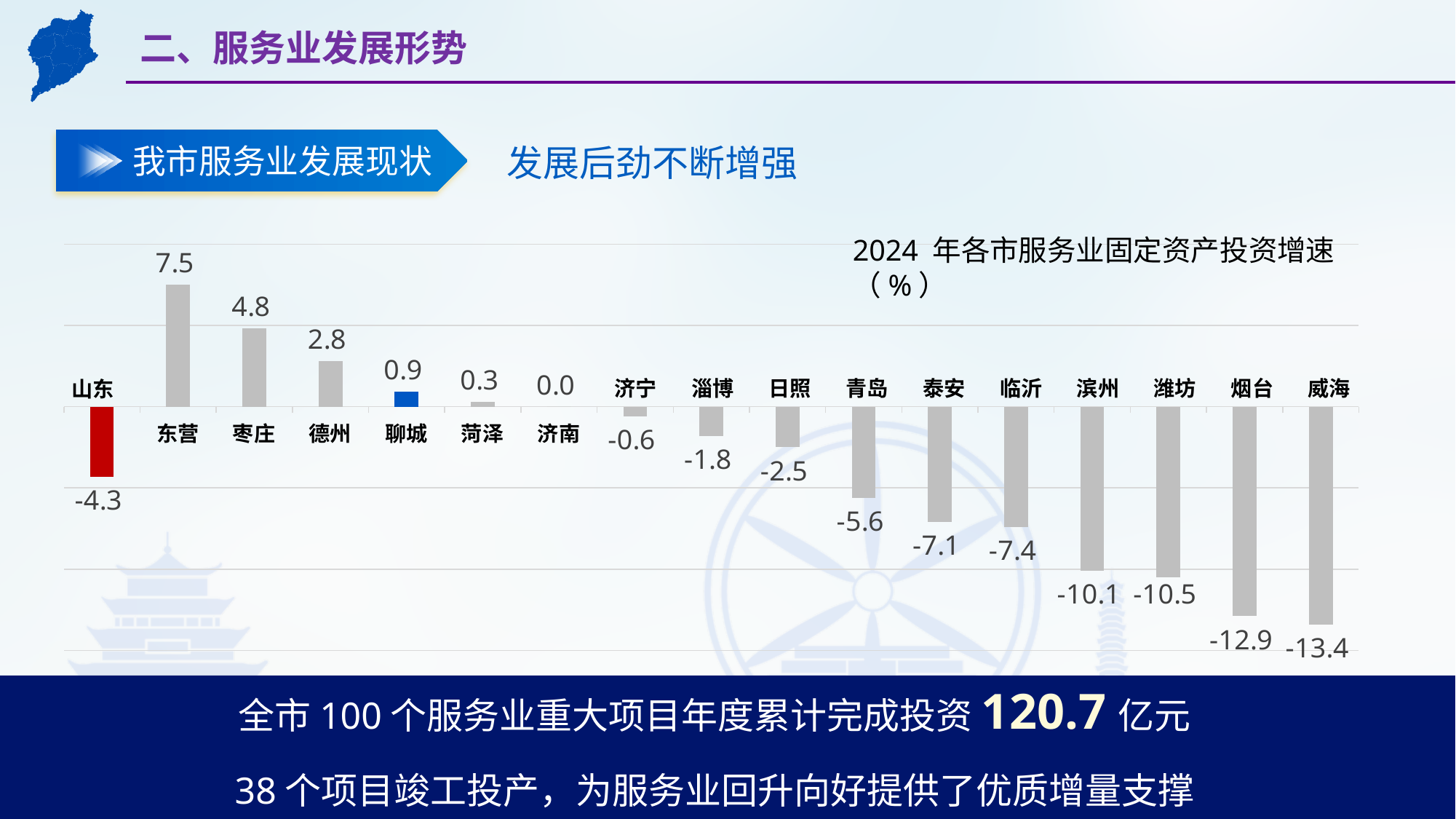
What is the value for 潍坊 in the chart? -10.5 What is the difference between the values for 东营 and 枣庄? 2.7 What is the title of the chart? 2024 年各市服务业固定资产投资增速（%） What type of chart is shown on the slide? Bar chart Which city has the lowest value in the chart? 威海 How many cities/categories are shown in the chart? 17 Which city has the highest value in the chart? 东营 What is the value for 东营 in the chart? 7.5 Which has a larger value, 青岛 or 日照? 日照 Do the values rise or fall from left to right along the x axis? Fall What is the value for 聊城 in the chart? 0.9 What is the value for 山东 in the chart? -4.3